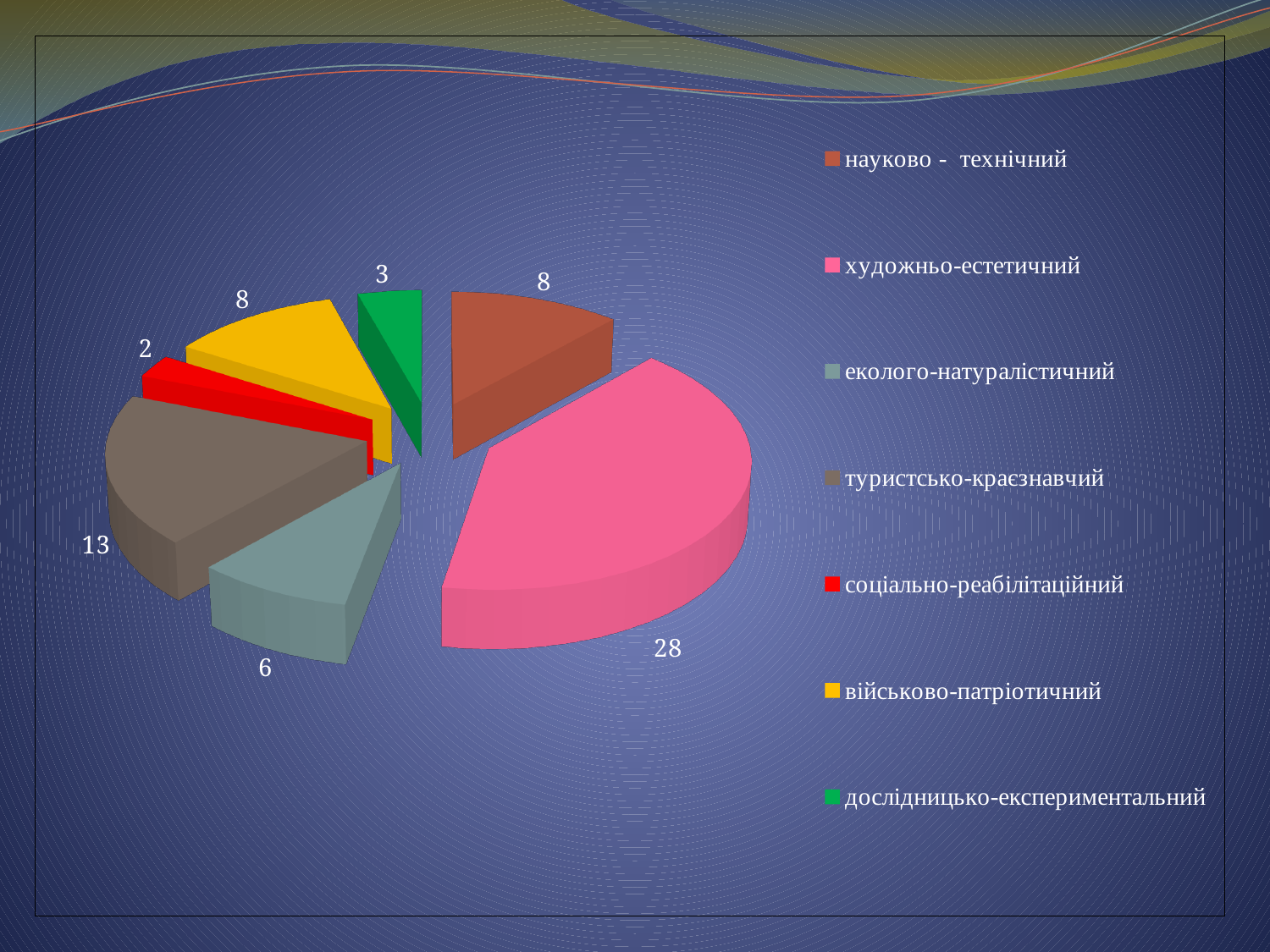
Which category has the largest slice? художньо-естетичний What is the value for еколого-натуралістичний? 6 Which category has the smallest slice? соціально-реабілітаційний Which is larger, the value for туристсько-краєзнавчий or the value for військово-патріотичний? туристсько-краєзнавчий What is the difference between the values for художньо-естетичний and туристсько-краєзнавчий? 15 What is the value for дослідницько-експериментальний? 3 What is the value for художньо-естетичний? 28 What is the value for туристсько-краєзнавчий? 13 What is the total of all the slice values in the pie chart? 68 What type of chart is shown on the slide? pie chart How many categories does the pie chart have? 7 What colour is the slice for соціально-реабілітаційний? red